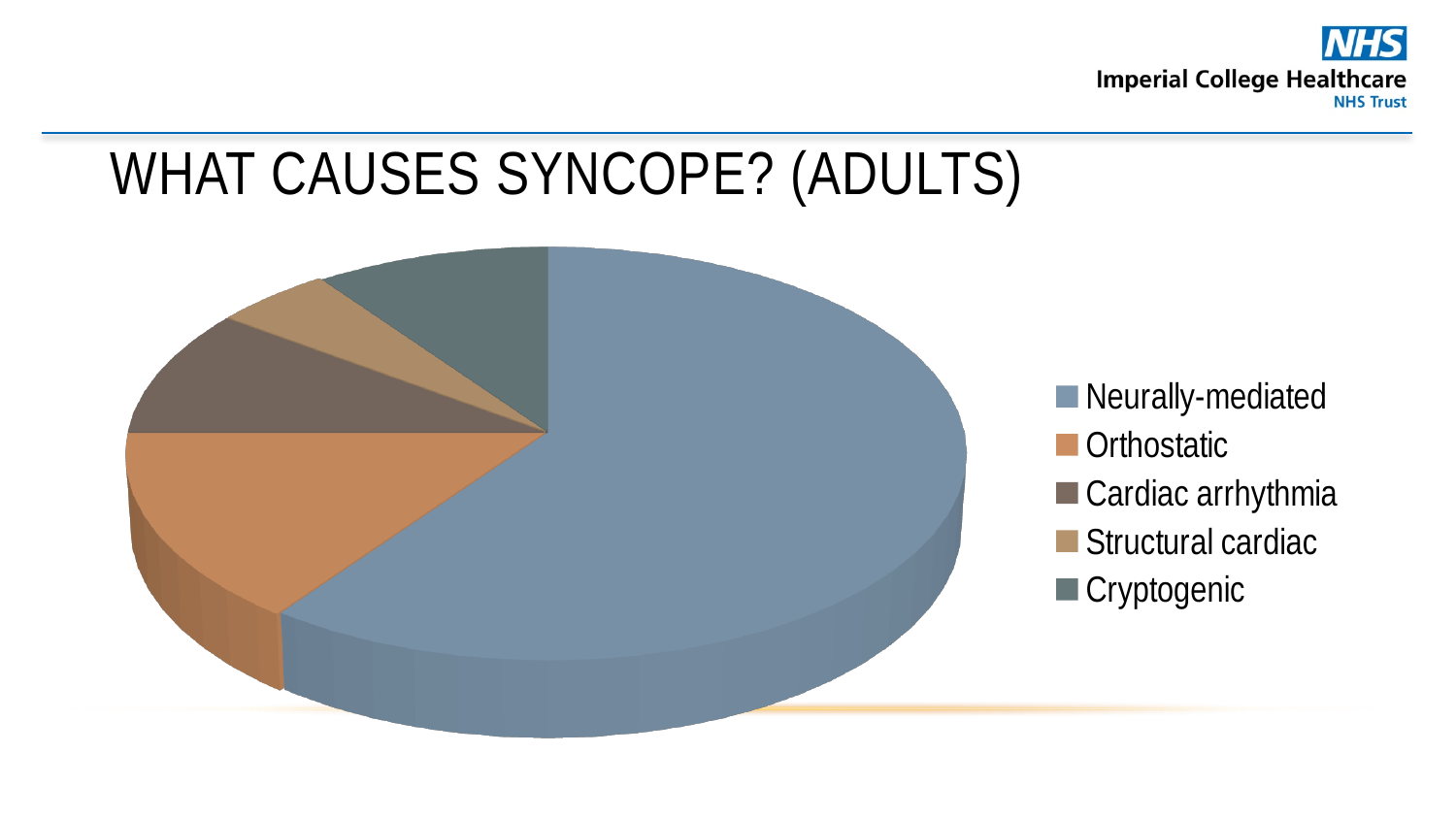
Does the Neurally-mediated slice make up more or less than half of the pie? more Which category has the smallest slice of the pie? Structural cardiac How many categories does the pie chart show? 5 Which slice is larger, Neurally-mediated or Orthostatic? Neurally-mediated Which category has the largest slice of the pie? Neurally-mediated What is the title of the slide containing the pie chart? WHAT CAUSES SYNCOPE? (ADULTS) What kind of chart is shown on the slide? Pie chart Which slice is larger, Cardiac arrhythmia or Structural cardiac? Cardiac arrhythmia Which slice is larger, Orthostatic or Cryptogenic? Orthostatic Which category is shown in orange in the pie chart? Orthostatic